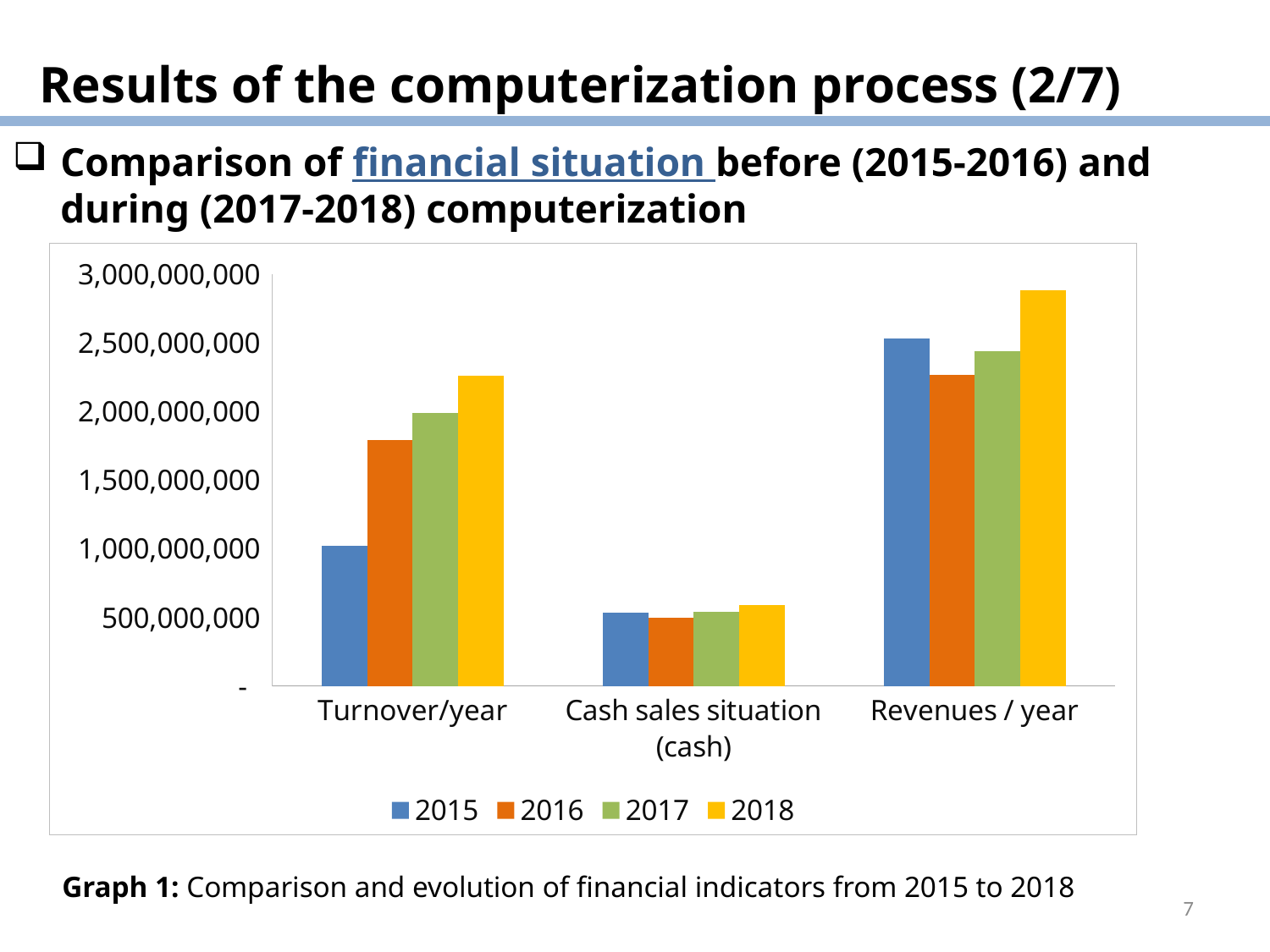
Which year has the lowest Revenues / year value? 2016 Which year has the highest Turnover/year value? 2018 Which year has the lowest Turnover/year value? 2015 How many categories are shown on the x axis of the chart? 3 Do the Turnover/year values rise or fall from 2015 to 2018? rise Which year has the highest Revenues / year value? 2018 What kind of chart is shown on the slide? bar chart Which years are listed in the chart legend? 2015, 2016, 2017, 2018 How many series does the chart legend list? 4 Which is larger: Turnover/year for 2016 or Turnover/year for 2018? Turnover/year for 2018 Is the Turnover/year value for 2015 greater or less than 1,500,000,000? less